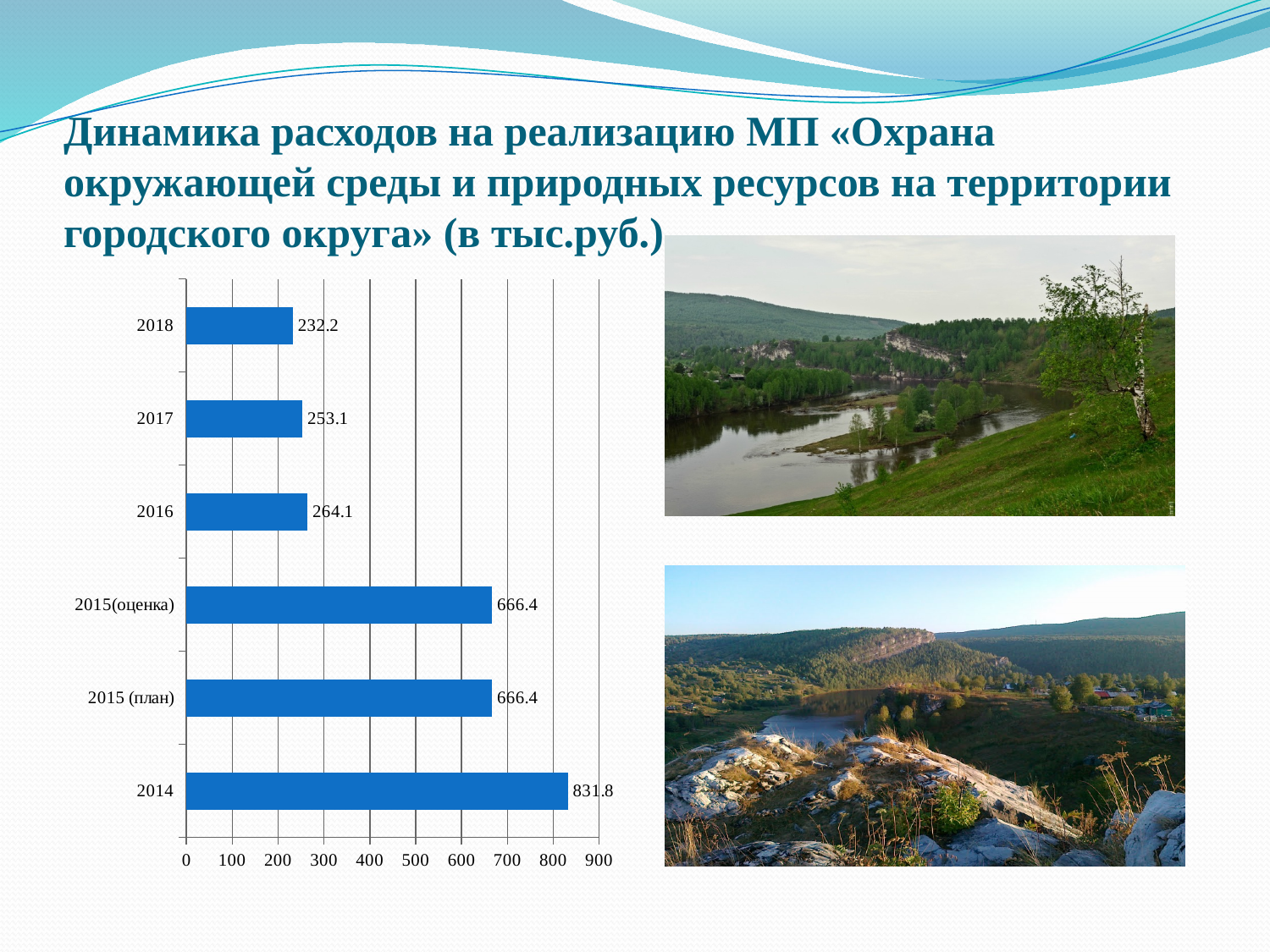
What is the value for 2015 (план)? 666.4 What is the value for 2016? 264.1 What kind of chart is shown on the slide? bar chart Which category has the highest value? 2014 What is the value for 2018? 232.2 Which category has the lowest value? 2018 How many categories are shown in the chart? 6 Do the values rise or fall from 2014 to 2018? fall What is the difference between the values for 2014 and 2018? 599.6 What is the difference between the values for 2016 and 2017? 11 What is the value for 2014? 831.8 Which is larger, the value for 2017 or the value for 2016? 2016